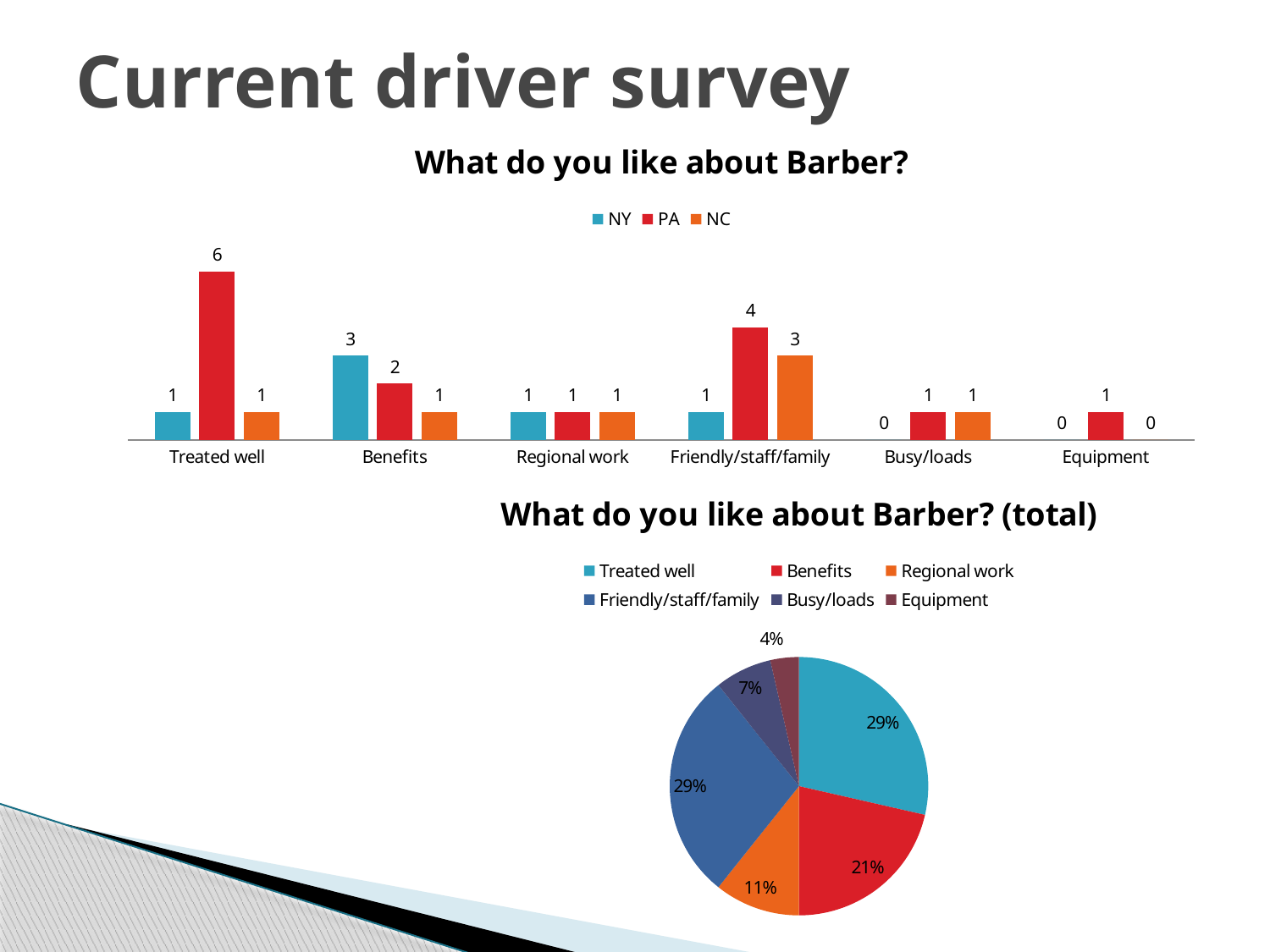
In the chart 'What do you like about Barber?', which is larger for Friendly/staff/family: the PA value or the NC value? PA What kind of chart is 'What do you like about Barber?'? bar chart In the pie chart 'What do you like about Barber? (total)', which category has the smallest share? Equipment In the pie chart 'What do you like about Barber? (total)', how many categories does the legend list? 6 In the pie chart 'What do you like about Barber? (total)', what share does Benefits have? 21% In the chart 'What do you like about Barber?', what is the PA value for Treated well? 6 In the chart 'What do you like about Barber?', how many categories are shown on the x axis? 6 In the chart 'What do you like about Barber?', how many series does the legend list? 3 In the chart 'What do you like about Barber?', what is the NC value for Friendly/staff/family? 3 In the chart 'What do you like about Barber?', what is the difference between the PA and NY values for Treated well? 5 In the chart 'What do you like about Barber?', which category has the highest PA value? Treated well In the chart 'What do you like about Barber?', what is the NY value for Benefits? 3